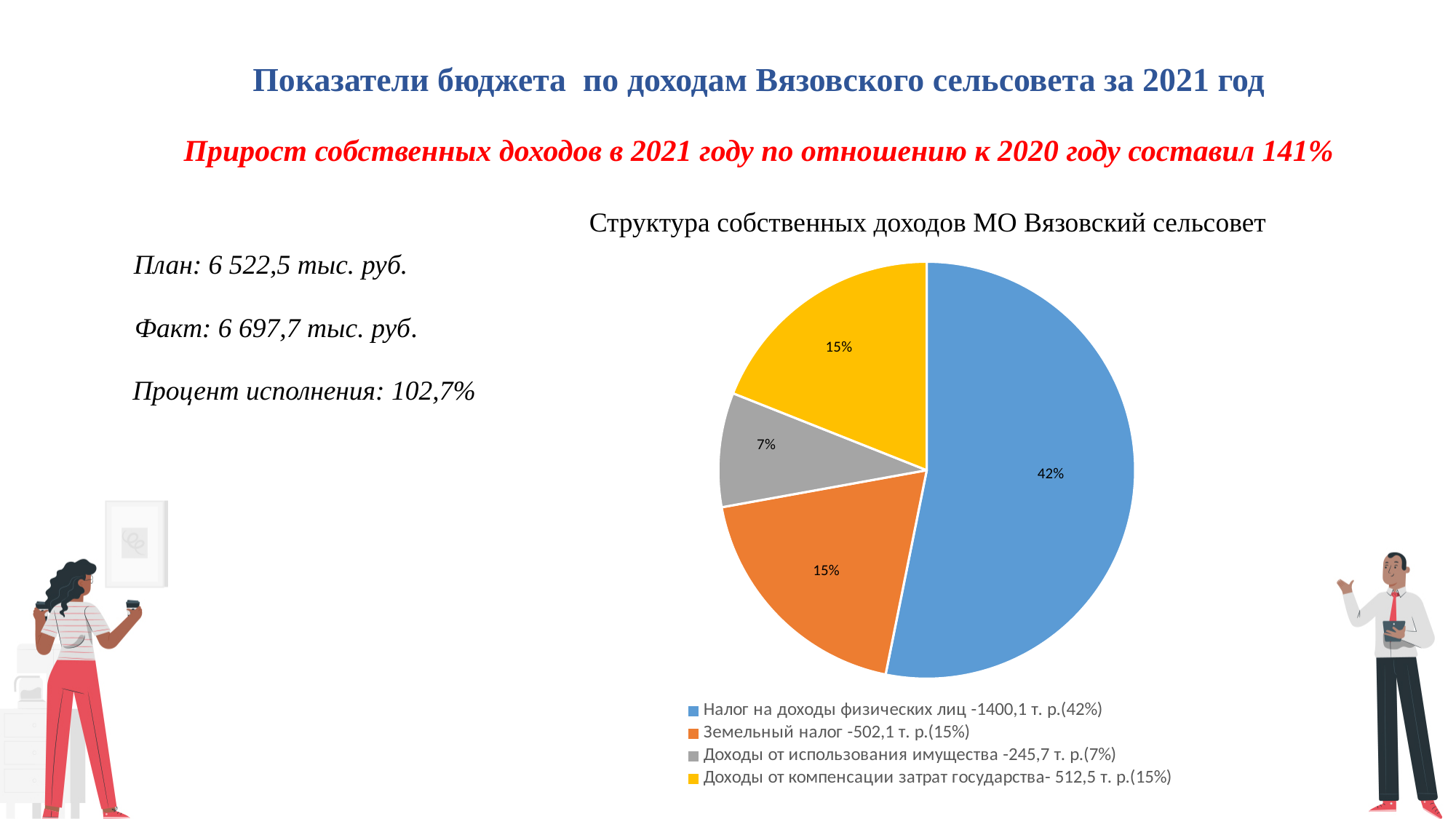
By how many percentage points does the "Налог на доходы физических лиц" slice exceed the "Доходы от использования имущества" slice? 35 What is the title of the pie chart? Структура собственных доходов МО Вязовский сельсовет What kind of chart is shown on the slide? pie chart What share of the pie does "Налог на доходы физических лиц" take? 42% What share of the pie does "Доходы от использования имущества" take? 7% Which slice is larger: "Земельный налог" or "Доходы от использования имущества"? Земельный налог Which category has the smallest slice of the pie? Доходы от использования имущества How many slices does the pie chart have? 4 What share of the pie does "Земельный налог" take? 15% Which category has the largest slice of the pie? Налог на доходы физических лиц According to the legend, what amount is given for "Доходы от компенсации затрат государства"? 512,5 т. р. According to the legend, what amount is given for "Земельный налог"? 502,1 т. р.